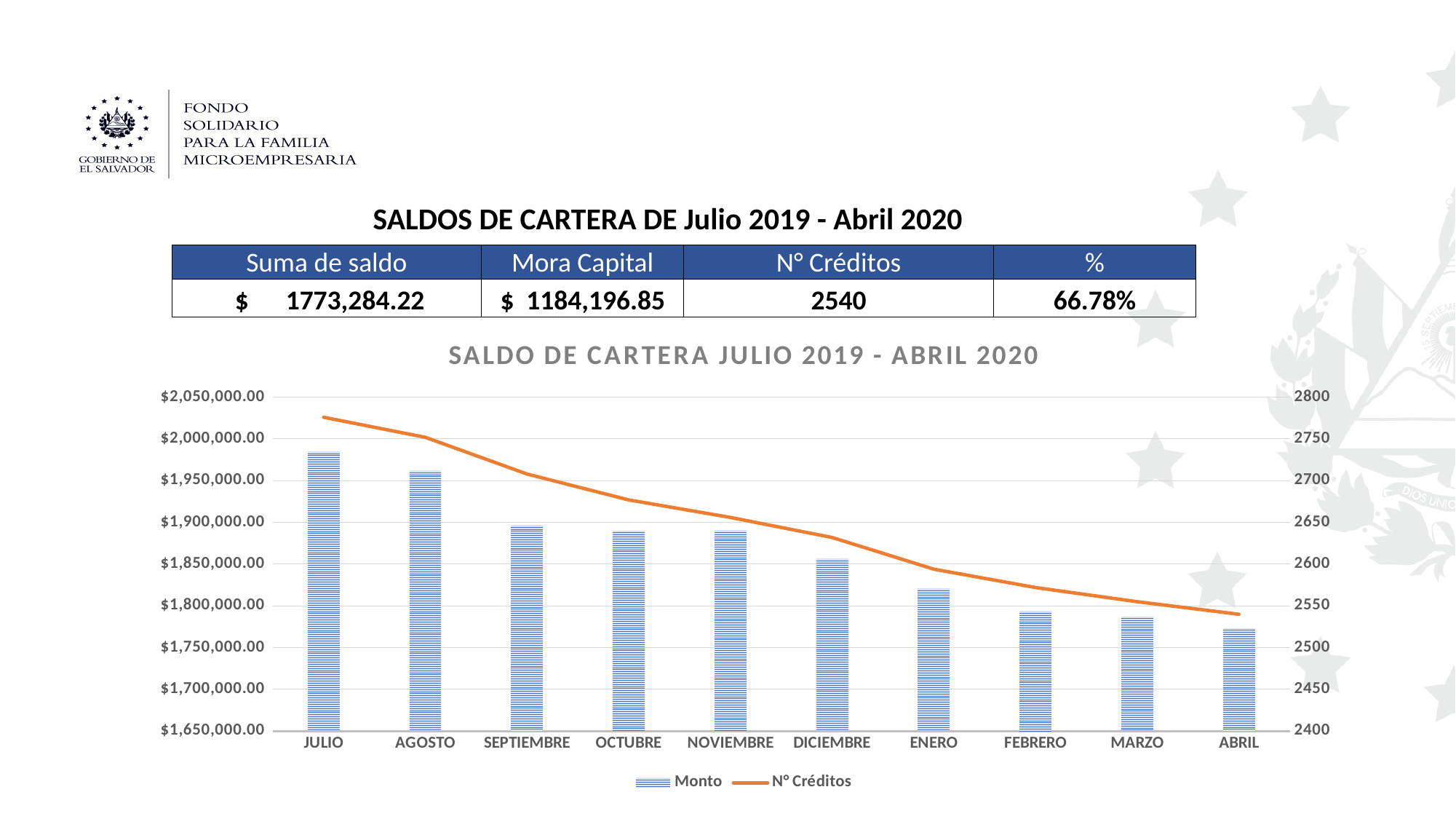
How many months are shown on the x axis of the chart? 10 What kind of chart is used to show the Monto series? Bar chart Is the N° Créditos value for JULIO greater or less than 2750? greater Does the N° Créditos line rise or fall from JULIO to ABRIL? Fall Which month has the lowest Monto bar in the chart? ABRIL Which month has the highest Monto bar in the chart? JULIO Is the N° Créditos value for OCTUBRE greater or less than 2650? greater Which has the larger Monto bar, AGOSTO or SEPTIEMBRE? AGOSTO Is the Monto value for ENERO greater or less than $1,800,000.00? greater How many series does the chart legend list? 2